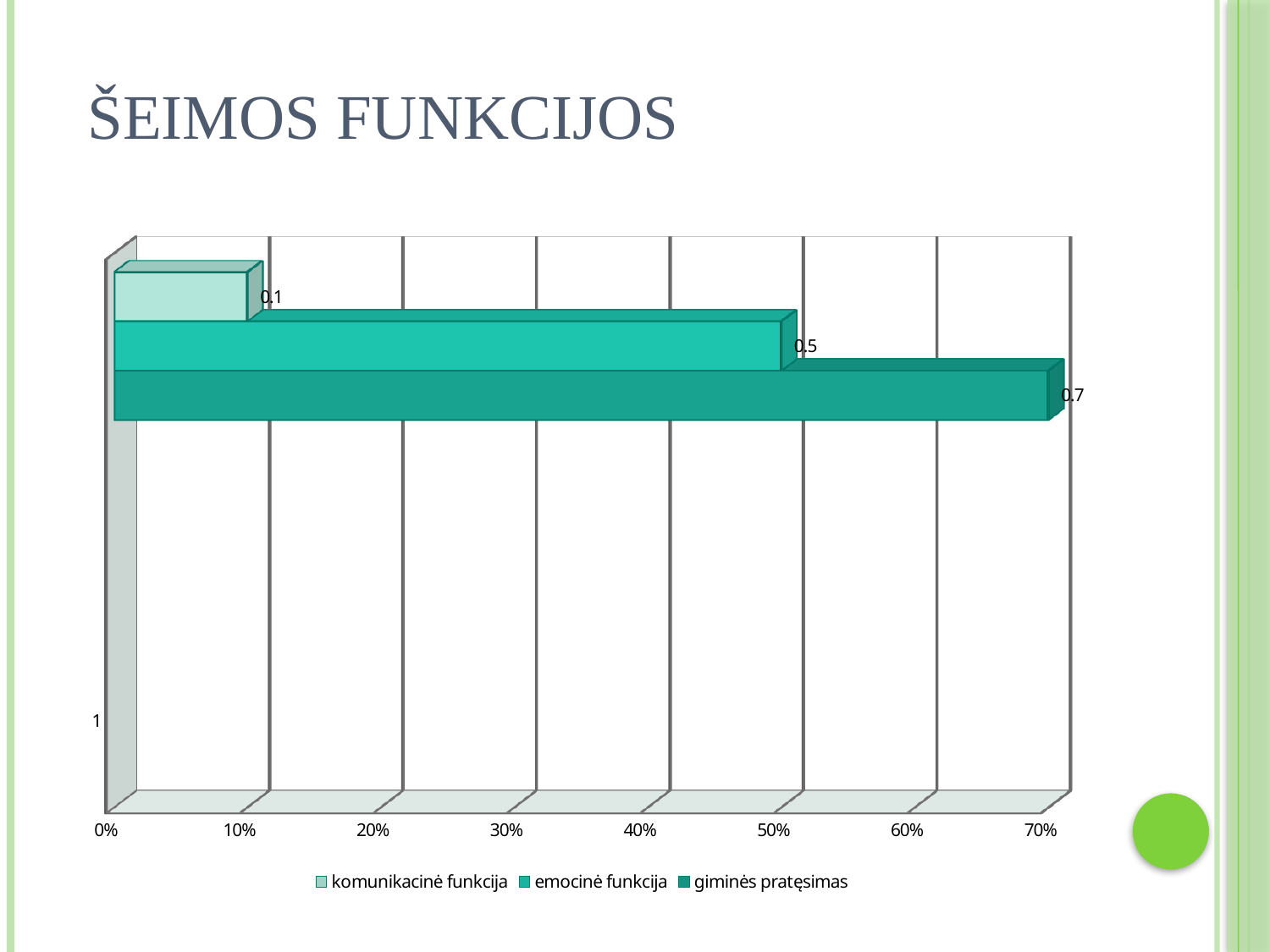
What value is shown for the 'emocinė funkcija' bar? 0.5 Which series has the lowest value? komunikacinė funkcija What value is shown for the 'komunikacinė funkcija' bar? 0.1 What value is shown for the 'giminės pratęsimas' bar? 0.7 Is the value for 'giminės pratęsimas' greater or less than 60%? greater Which is larger, the value for 'emocinė funkcija' or the value for 'komunikacinė funkcija'? emocinė funkcija What is the difference between the values for 'emocinė funkcija' and 'komunikacinė funkcija'? 0.4 What kind of chart is shown on the slide? bar chart Which series has the highest value? giminės pratęsimas What is the difference between the values for 'giminės pratęsimas' and 'emocinė funkcija'? 0.2 What is the title of the slide containing the chart? ŠEIMOS FUNKCIJOS How many series does the legend list? 3